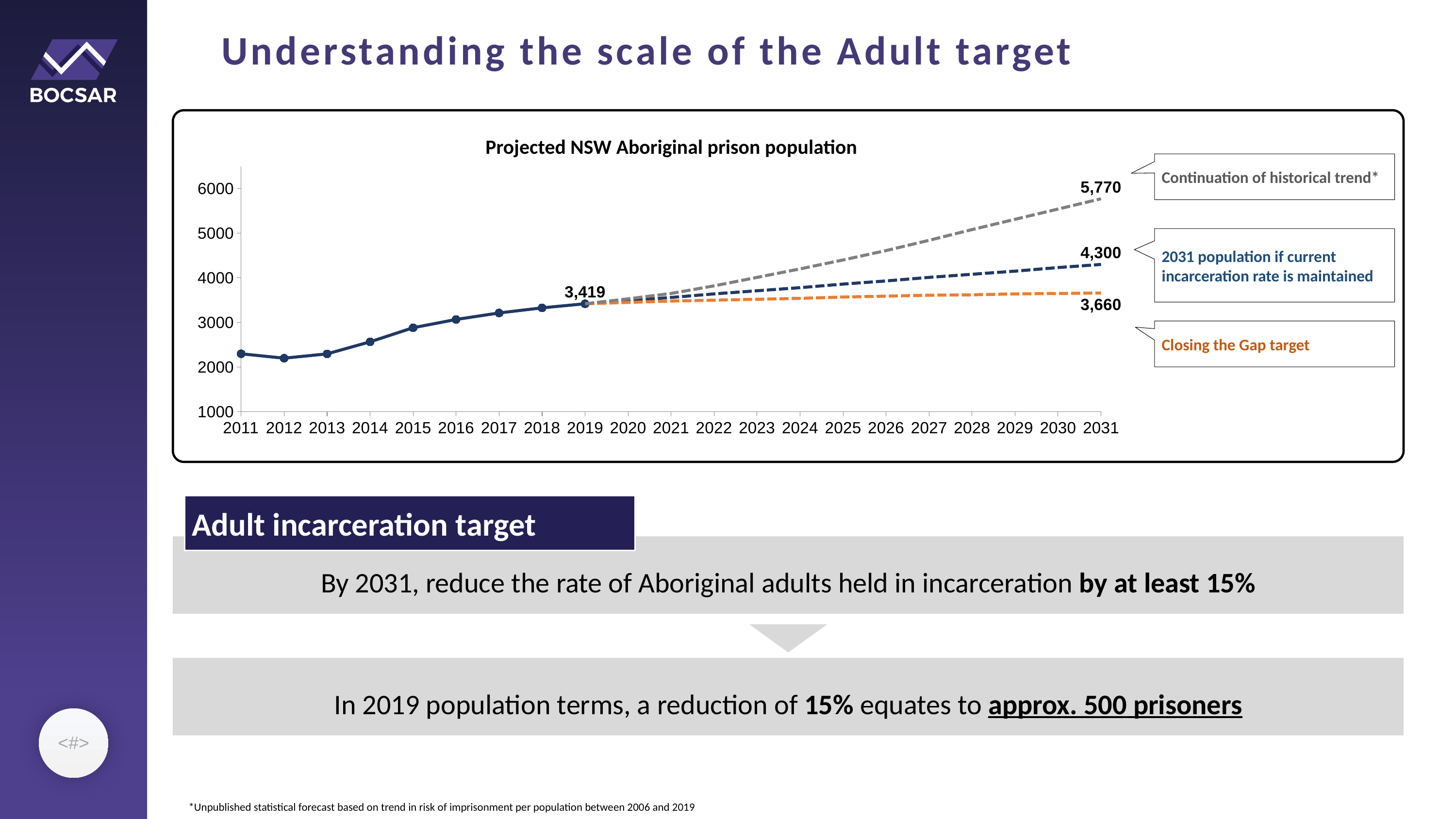
Which of the three 2031 projections is the highest? Continuation of historical trend Does the prison population rise or fall between 2013 and 2019? Rise What is the value of the NSW Aboriginal prison population shown for 2019? 3,419 What is the Closing the Gap target value for 2031? 3,660 What is the title of the chart? Projected NSW Aboriginal prison population What is the projected 2031 prison population under the continuation of historical trend? 5,770 What is the 2031 prison population if the current incarceration rate is maintained? 4,300 Which is larger in 2031: the value if the current incarceration rate is maintained or the Closing the Gap target? The value if the current incarceration rate is maintained What kind of chart is shown on the slide? Line chart How much higher is the 2031 value if the current incarceration rate is maintained than the 2019 value? 881 What is the difference between the 2031 continuation of historical trend value and the Closing the Gap target value? 2,110 Is the value for 2012 greater or less than 3000? less